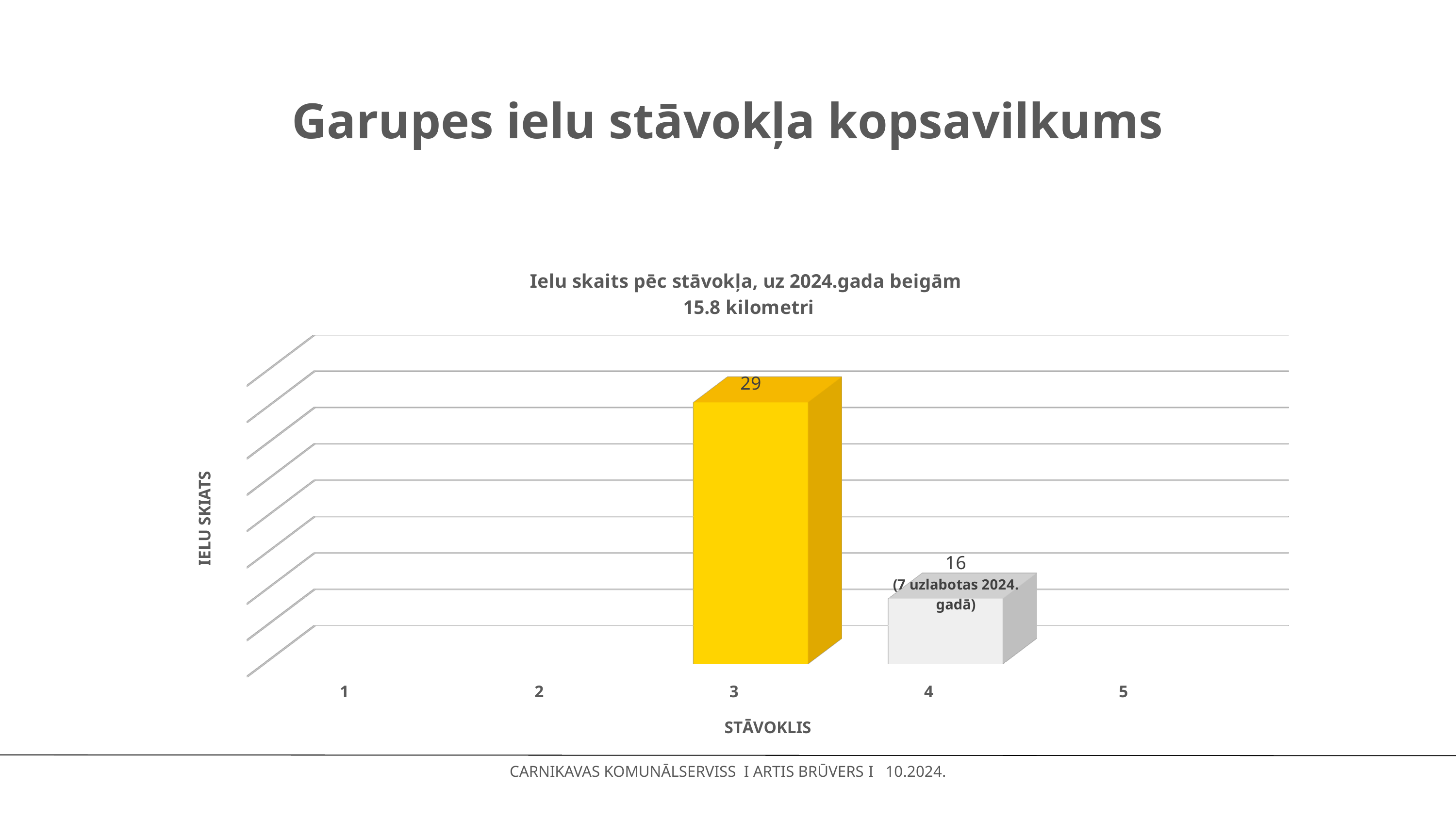
Which condition category has the highest number of streets? 3 How many condition categories are shown on the x axis? 5 What is the title of the chart? Ielu skaits pēc stāvokļa, uz 2024.gada beigām 15.8 kilometri How many categories have a bar with a data label? 2 What kind of chart is shown on the slide? Bar chart What is the label of the x axis? STĀVOKLIS Which is larger, the value for condition 3 or the value for condition 4? Condition 3 What is the value for condition (stāvoklis) 4? 16 What colour is the bar for condition 3? Yellow What is the value for condition (stāvoklis) 3? 29 What is the difference between the values for condition 3 and condition 4? 13